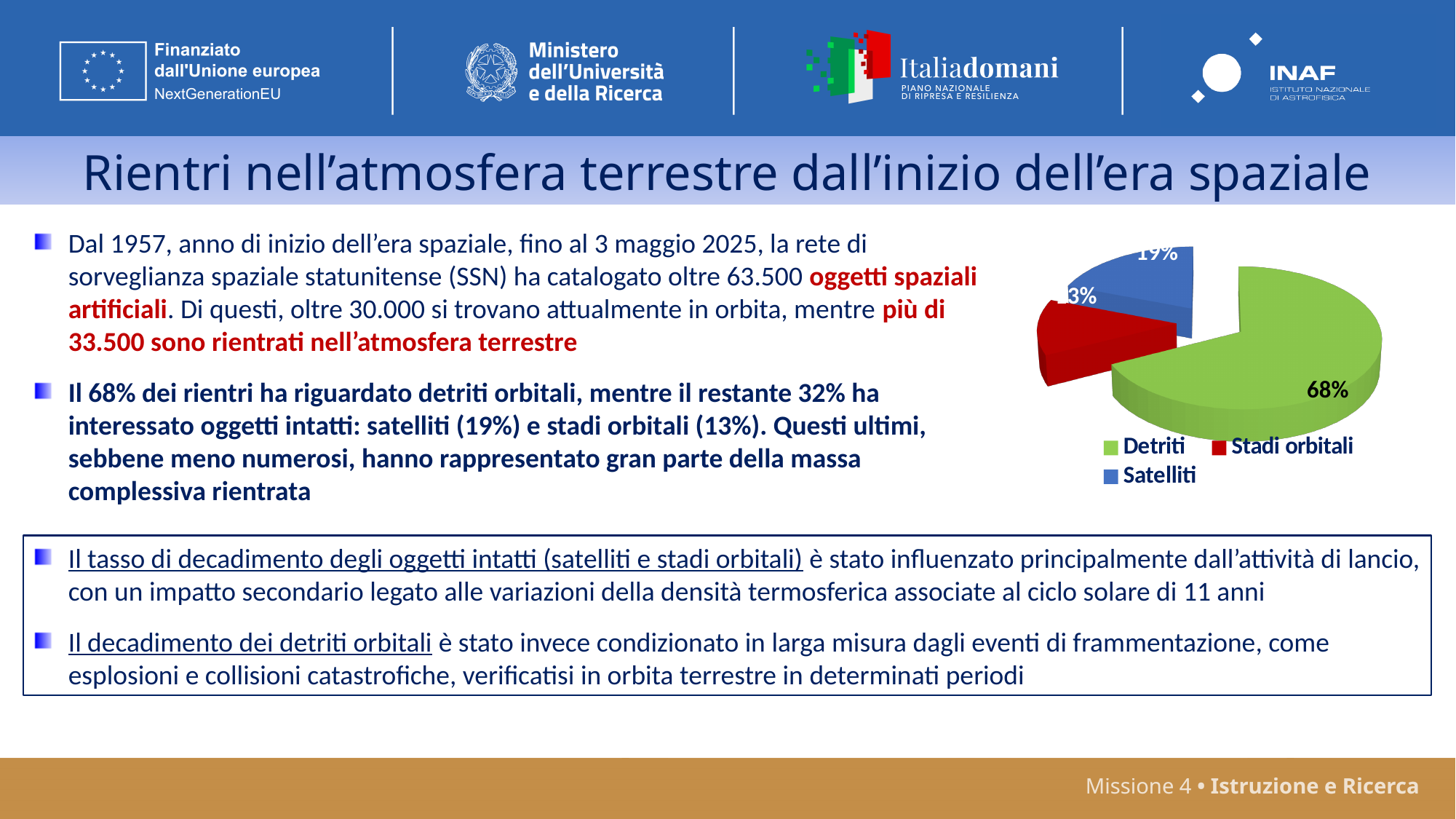
What colour is the Detriti slice in the pie chart? green Which category has the smallest slice in the pie chart? Stadi orbitali What is the difference in percentage points between the Detriti slice and the Satelliti slice? 49 What share of the pie chart is Satelliti? 19% What share of the pie chart is Stadi orbitali? 13% How many slices does the pie chart have? 3 Which category has the largest slice in the pie chart? Detriti Which is larger in the pie chart, Satelliti or Stadi orbitali? Satelliti What kind of chart is shown on the slide? pie chart How many entries does the legend of the pie chart list? 3 What share of the pie chart is Detriti? 68% What colour is the Stadi orbitali slice in the pie chart? red